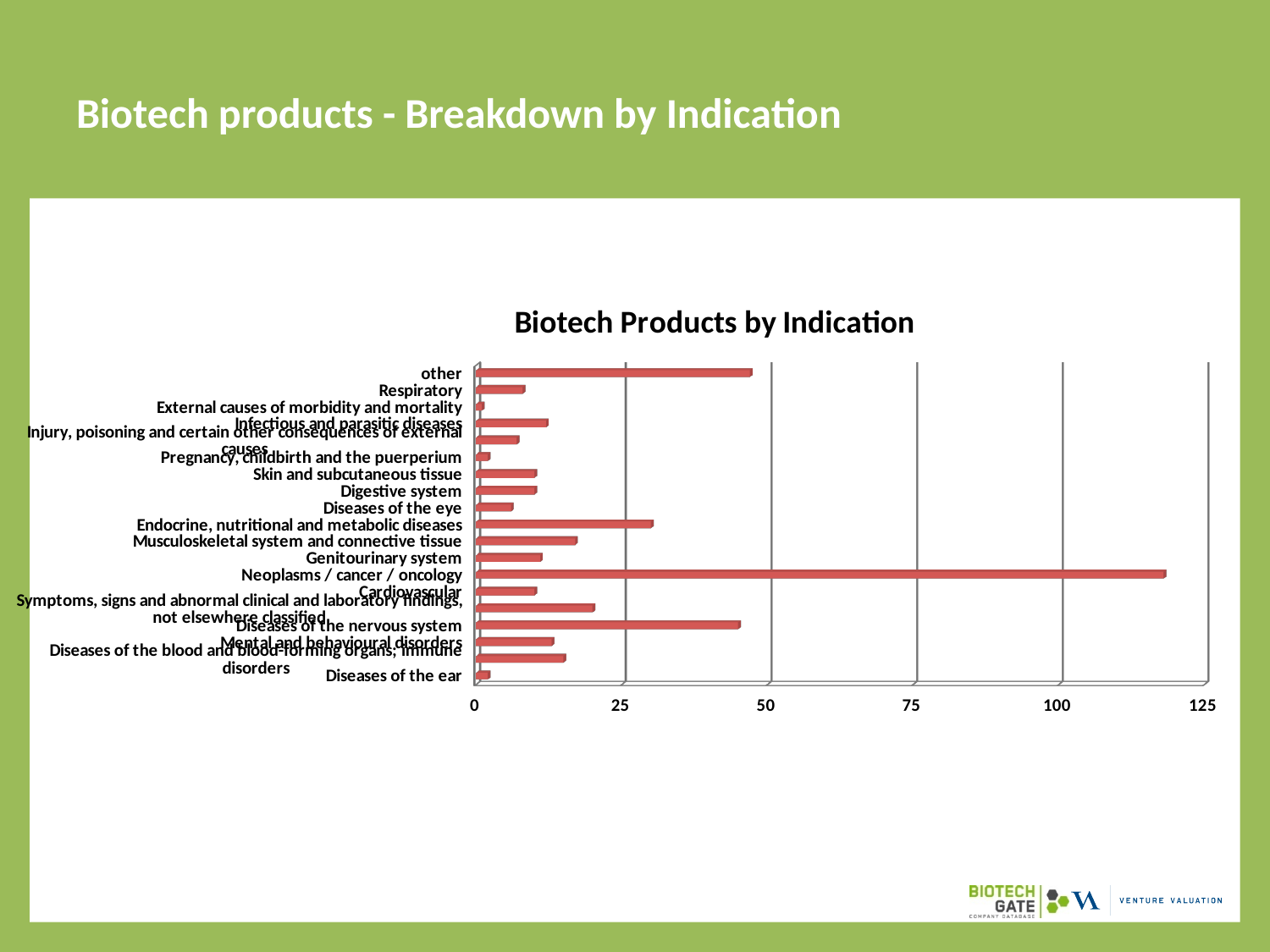
Which is larger, the value for Neoplasms / cancer / oncology or for 'other'? Neoplasms / cancer / oncology Is the value for Diseases of the nervous system greater or less than 25? greater What kind of chart is shown on the slide? bar chart Which indication category has the highest value? Neoplasms / cancer / oncology What is the title of the chart? Biotech Products by Indication Is the value for Endocrine, nutritional and metabolic diseases greater or less than 25? greater Which is larger, the value for Endocrine, nutritional and metabolic diseases or for Musculoskeletal system and connective tissue? Endocrine, nutritional and metabolic diseases Is the value for Respiratory greater or less than 25? less Which is larger, the value for Genitourinary system or for Diseases of the eye? Genitourinary system What is the highest value shown on the horizontal axis? 125